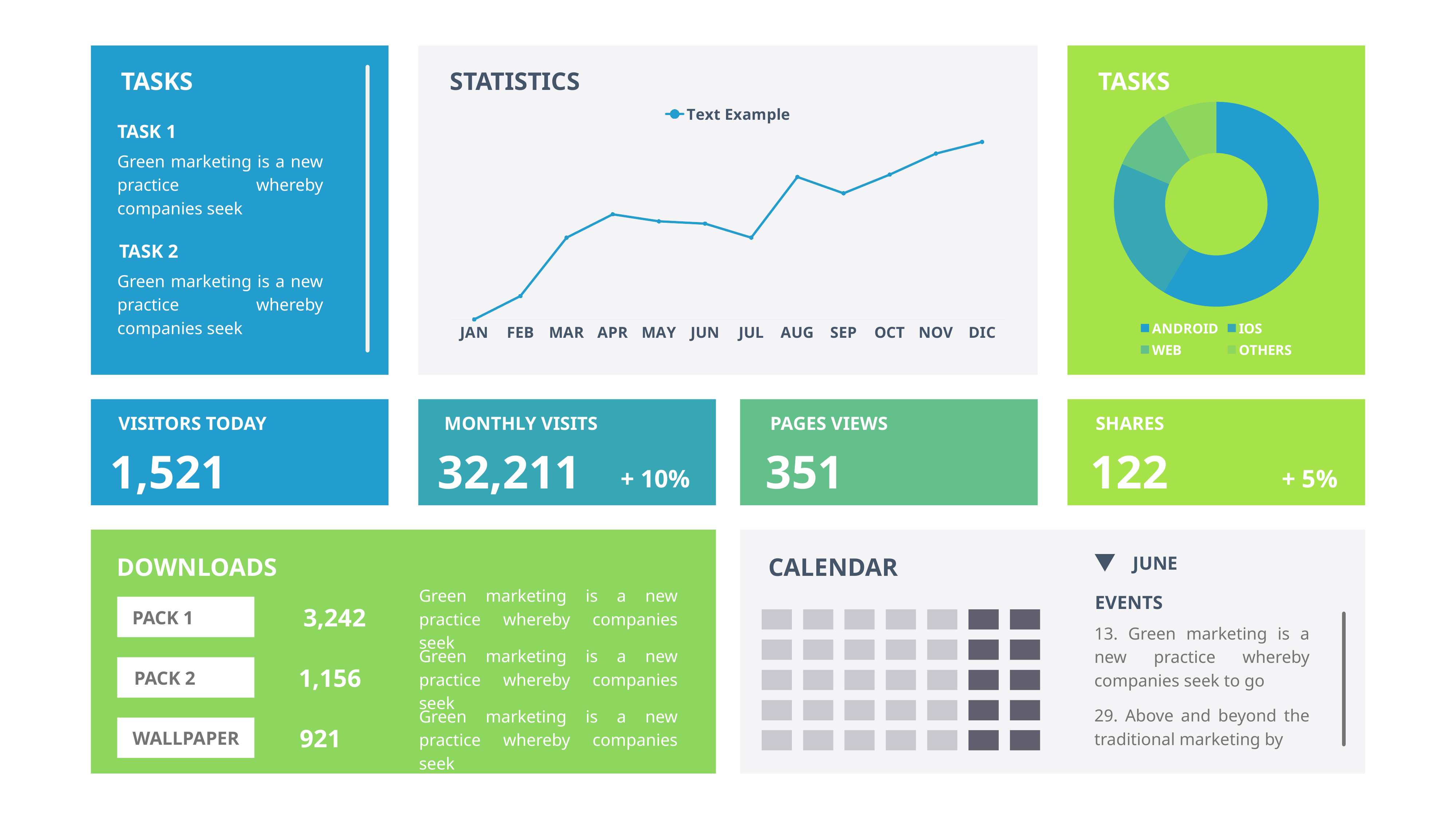
In the STATISTICS chart, do the values generally rise or fall from JAN to DIC? rise How many categories does the legend of the TASKS doughnut chart list? 4 How many series does the legend of the STATISTICS chart list? 1 What kind of chart is the TASKS chart on the right of the slide? doughnut chart What kind of chart is the STATISTICS chart? line chart What is the name of the series in the legend of the STATISTICS chart? Text Example In the STATISTICS chart, which month has the lowest value? JAN In the STATISTICS chart, which month has the highest value? DIC In the TASKS doughnut chart, which category has the largest share? ANDROID In the STATISTICS chart, which is larger, the value for APR or the value for FEB? APR In the STATISTICS chart, which is larger, the value for AUG or the value for JUL? AUG How many months are shown on the x axis of the STATISTICS chart? 12